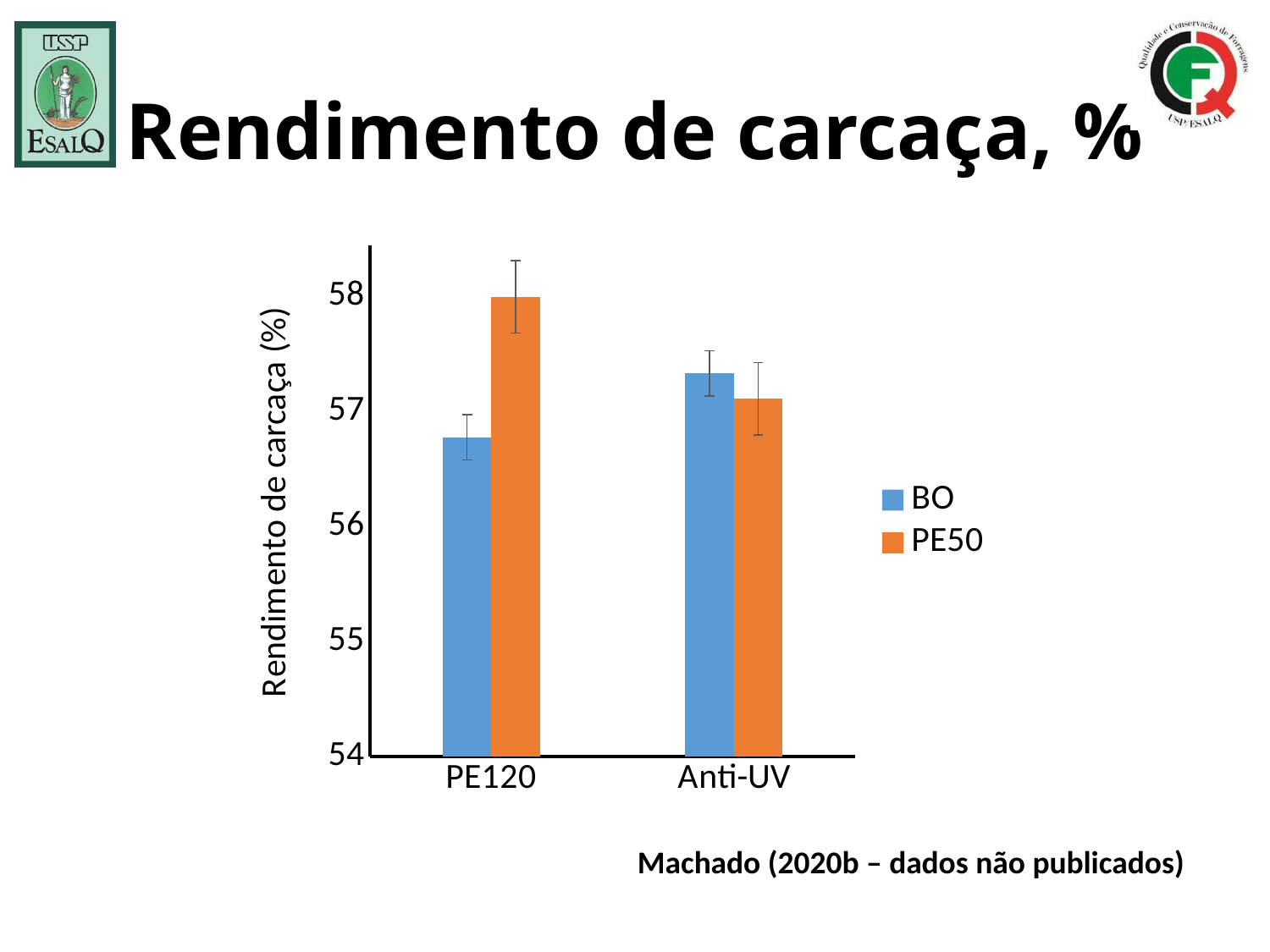
How many categories are shown on the x axis of the chart? 2 How many series does the chart legend list? 2 What is the label of the y axis of the chart? Rendimento de carcaça (%) Is the value for BO at PE120 greater or less than 57? less Is the value for BO at Anti-UV greater or less than 57? greater Is the value for BO at Anti-UV greater or less than 58? less Which series are listed in the chart legend? BO and PE50 Which bar in the chart is the lowest? BO at PE120 At PE120, which series has the larger value, BO or PE50? PE50 What kind of chart is shown on the slide? bar chart Which bar in the chart is the highest? PE50 at PE120